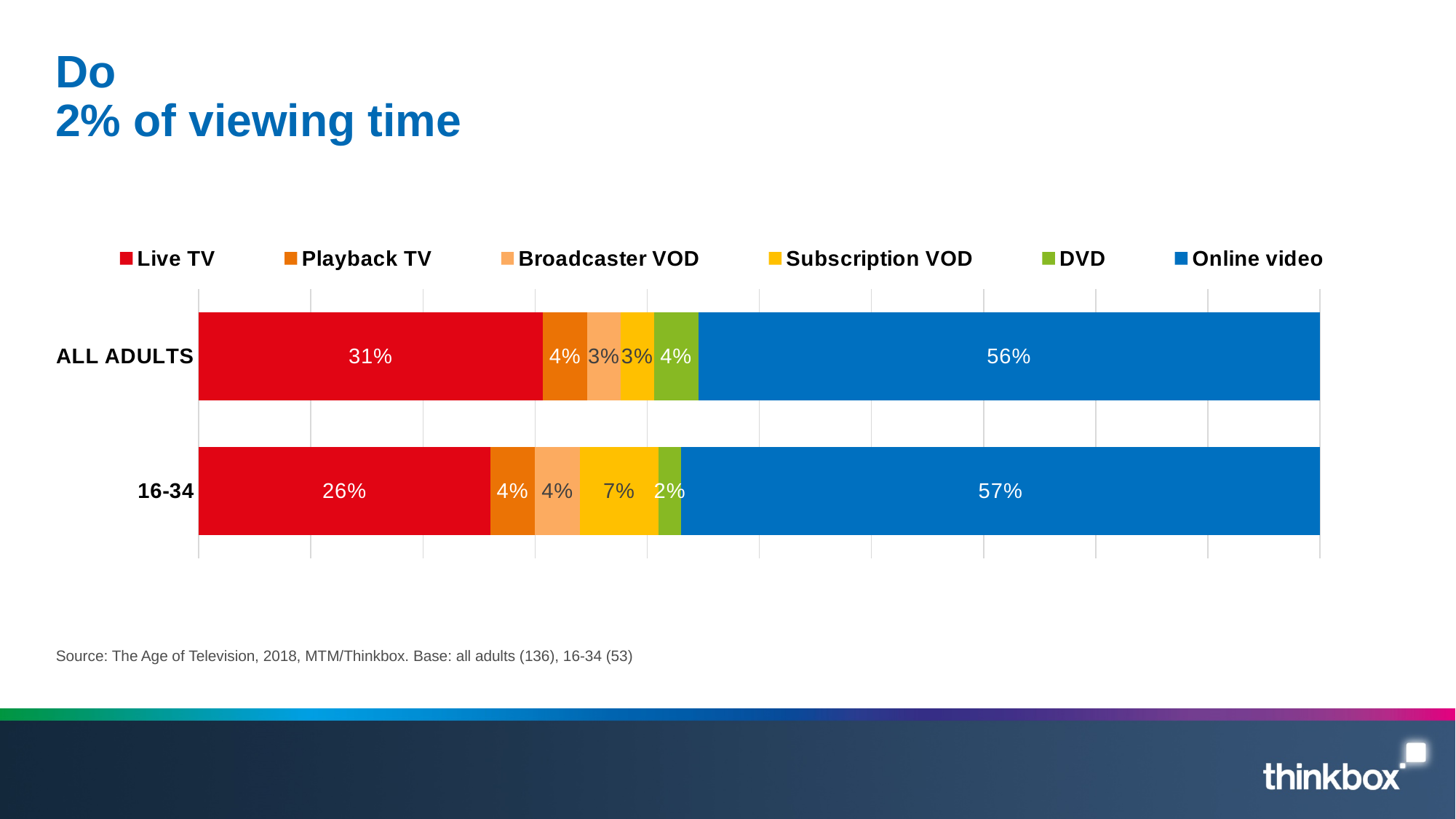
Which series has the largest share for ALL ADULTS? Online video What is the Live TV value for ALL ADULTS? 31% Which group has the larger Subscription VOD share, ALL ADULTS or 16-34? 16-34 What is the DVD value for ALL ADULTS? 4% Which series has the smallest share for the 16-34 group? DVD What is the difference between the Live TV values for ALL ADULTS and 16-34? 5% What is the Subscription VOD value for the 16-34 group? 7% How many categories (bars) are plotted in the chart? 2 Which series is shown in red in the chart? Live TV How many series does the legend list? 6 What is the Online video value for the 16-34 group? 57% What type of chart is shown on the slide? Stacked bar chart